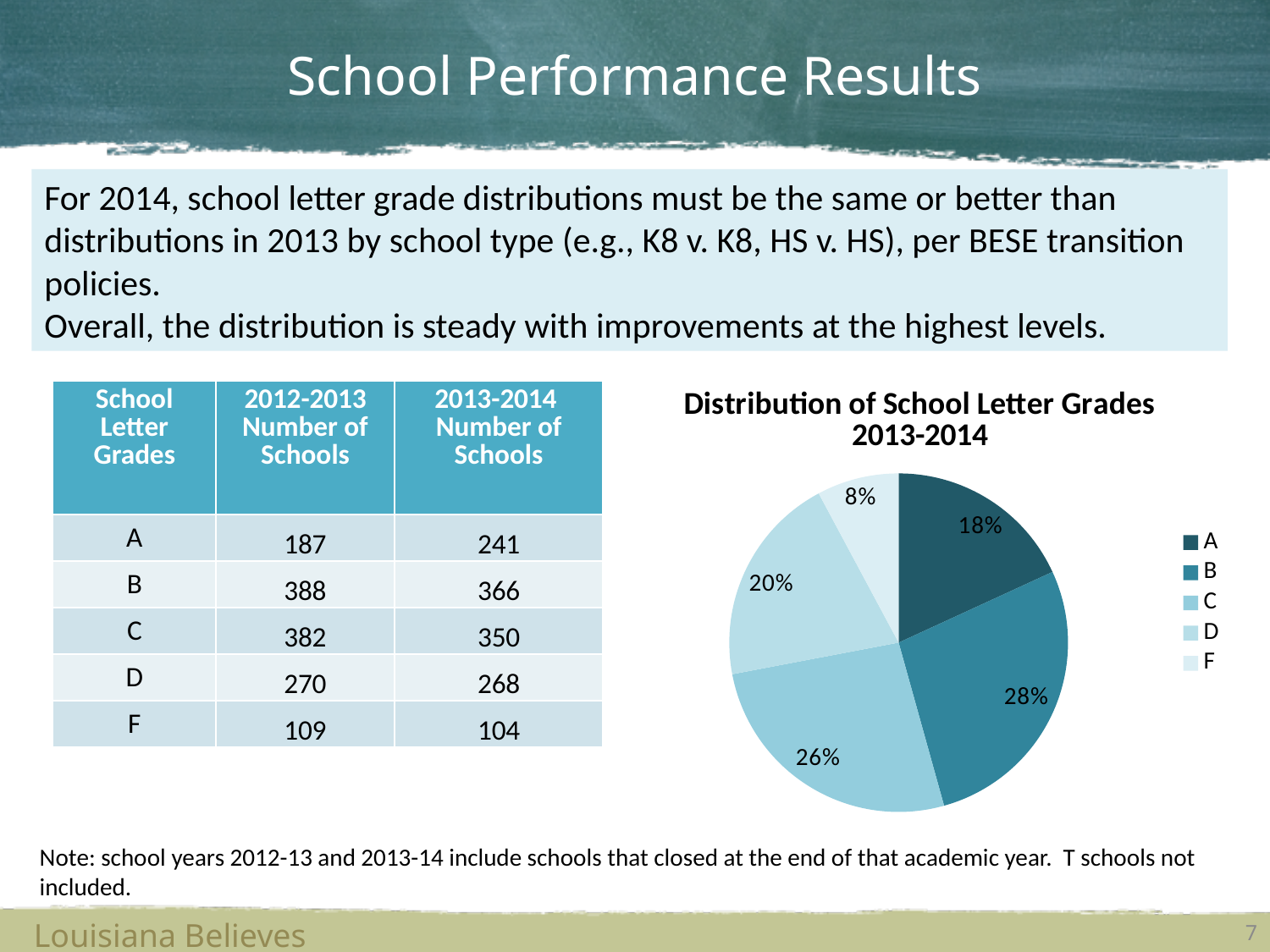
What is the difference in percentage points between the B slice and the A slice? 10 What share of the pie does letter grade D represent? 20% Which letter grade has the smallest slice of the pie? F How many entries does the pie chart's legend list? 5 What share of the pie does letter grade B represent? 28% How many slices does the pie chart have? 5 What is the title of the pie chart? Distribution of School Letter Grades 2013-2014 Which letter grade has the largest slice of the pie? B What share of the pie does letter grade F represent? 8% What type of chart is shown on the slide? pie chart